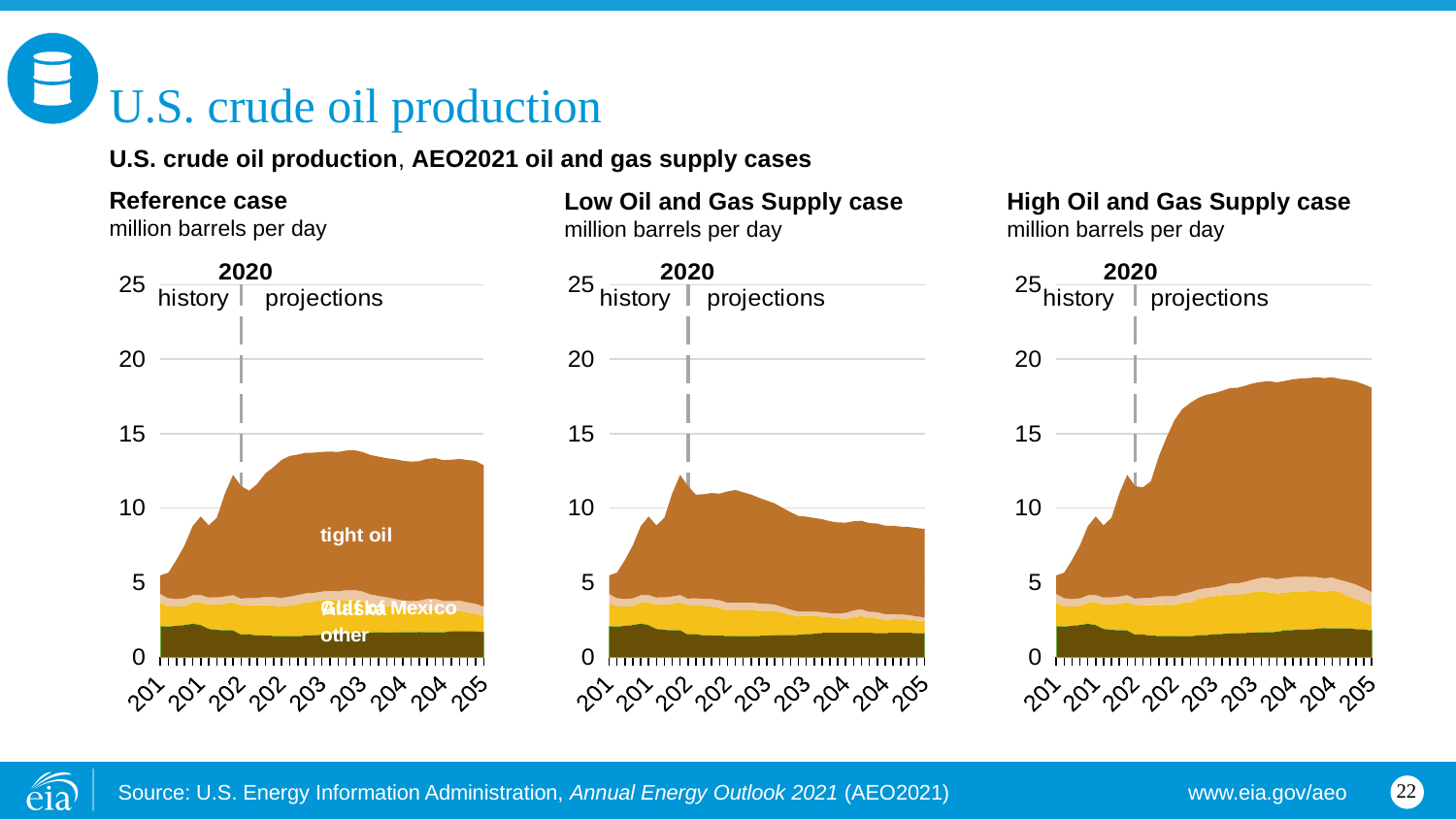
In the Low Oil and Gas Supply case chart, is the total crude oil production at the end of the projection period greater or less than 10 million barrels per day? less How many charts are shown on the slide? 3 In the Reference case chart, is the total crude oil production at the end of the projection period greater or less than 10 million barrels per day? greater In the High Oil and Gas Supply case chart, does total crude oil production ever exceed 20 million barrels per day? No In the Low Oil and Gas Supply case chart, does total crude oil production generally rise or fall over the projection period after 2020? fall Which of the three charts shows the highest total crude oil production at the end of the projection period? High Oil and Gas Supply case In the Reference case chart, which component makes up the largest share of crude oil production in the projection period? tight oil What unit is used on the y axis of the charts? million barrels per day In the High Oil and Gas Supply case chart, does total crude oil production rise or fall in the years immediately after 2020? rise What kind of chart is used for the Reference case? stacked area chart